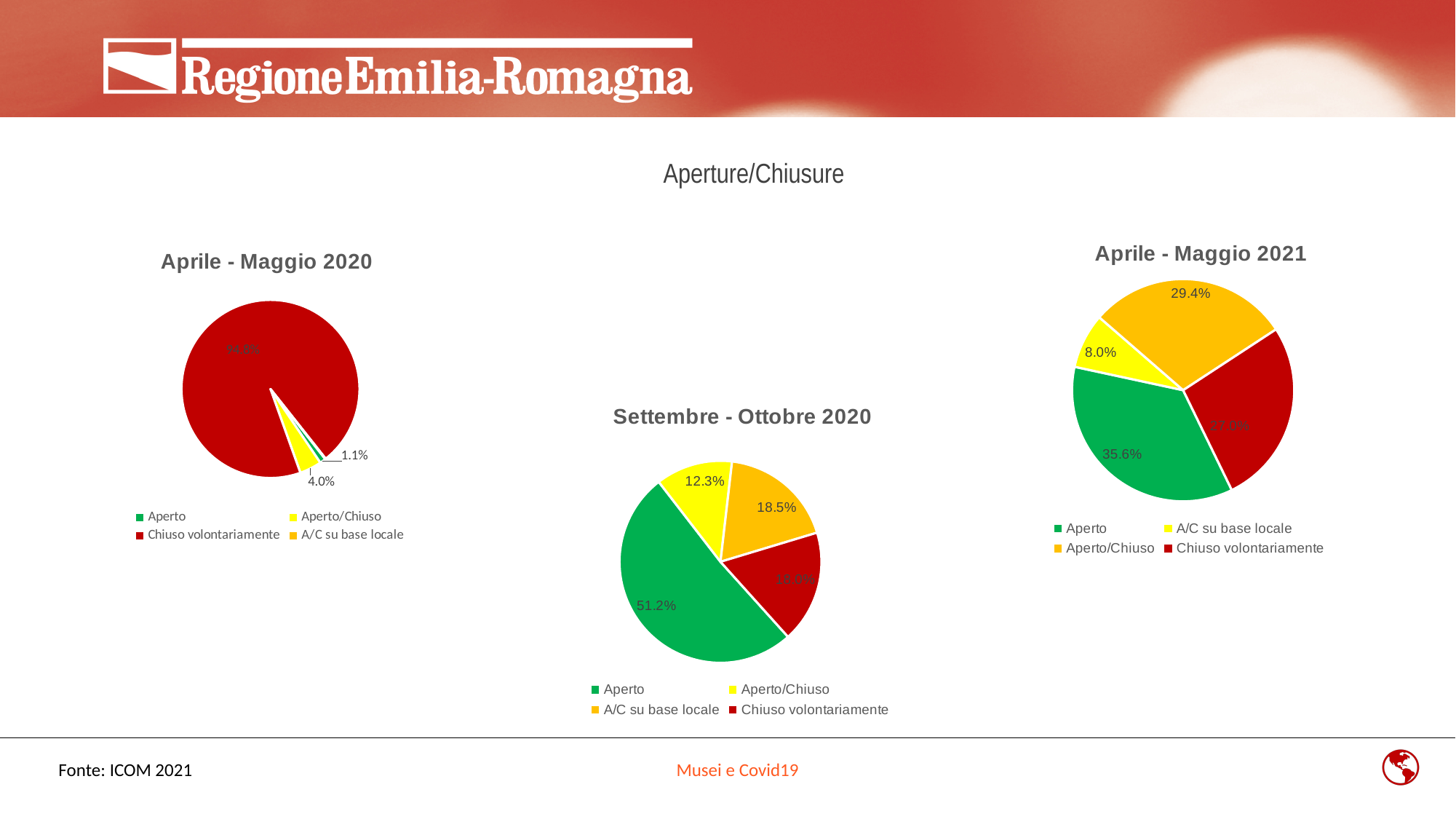
In the Aprile - Maggio 2021 chart, which category has the smallest slice? A/C su base locale In the Settembre - Ottobre 2020 chart, what is the share for Aperto/Chiuso? 12.3% In the Aprile - Maggio 2021 chart, what is the share for Aperto/Chiuso? 29.4% In the Settembre - Ottobre 2020 chart, what is the share for A/C su base locale? 18.5% In the Settembre - Ottobre 2020 chart, what is the difference in percentage points between Aperto and A/C su base locale? 32.7 percentage points In the Aprile - Maggio 2021 chart, what is the share for Aperto? 35.6% In the Aprile - Maggio 2021 chart, which is larger: Aperto or Aperto/Chiuso? Aperto In the Aprile - Maggio 2020 chart, what is the share for Aperto/Chiuso? 4.0% What type of charts are shown on the slide? Pie charts In the Aprile - Maggio 2020 chart, which category has the largest slice? Chiuso volontariamente In the Settembre - Ottobre 2020 chart, what is the share for Aperto? 51.2% In the Settembre - Ottobre 2020 chart, which category has the largest slice? Aperto